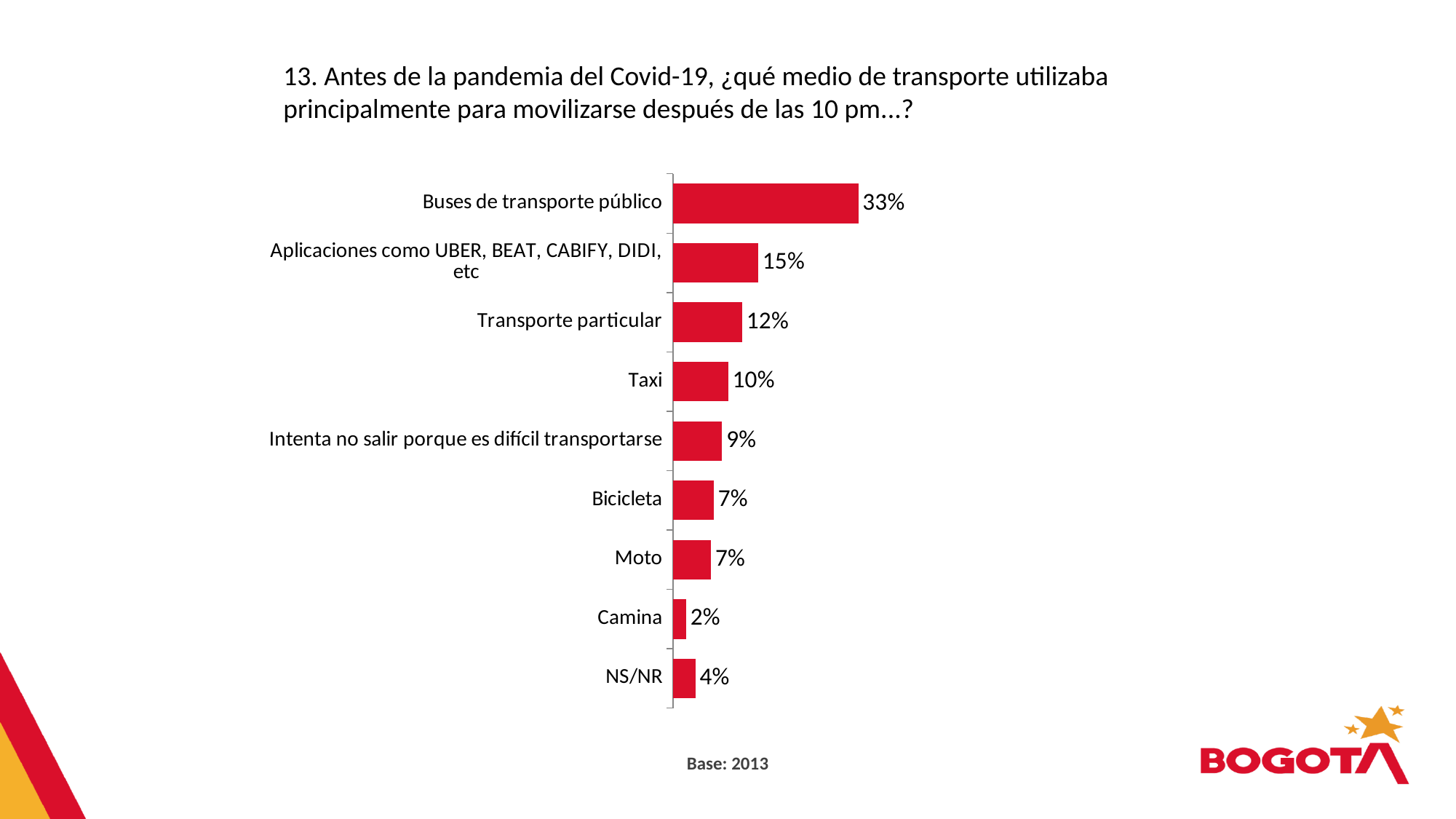
What percentage is shown for Buses de transporte público? 33% What base (sample size) is stated below the chart? 2013 What kind of chart is shown on the slide? Bar chart Which category has the highest value? Buses de transporte público What percentage is shown for Camina? 2% Which category has the lowest value? Camina What is the difference between Taxi and NS/NR? 6% What is the value for Taxi? 10% Which is larger, Transporte particular or Intenta no salir porque es difícil transportarse? Transporte particular What is the value for Aplicaciones como UBER, BEAT, CABIFY, DIDI, etc? 15% What is the difference between Buses de transporte público and Transporte particular? 21% How many categories are shown in the chart? 9